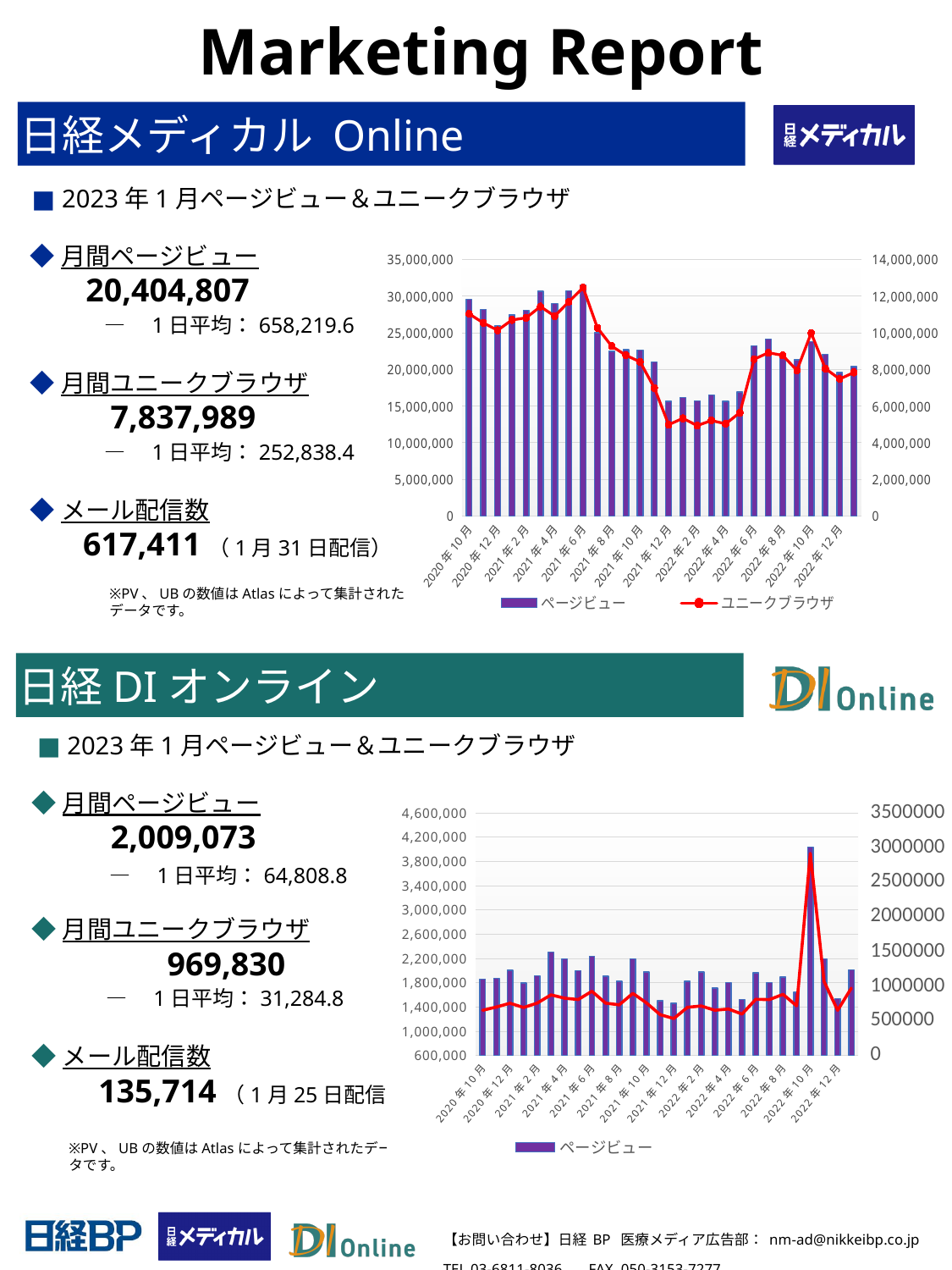
In the 日経メディカル Online chart, which month has the larger ページビュー bar, 2020年10月 or 2022年1月? 2020年10月 In the 日経メディカル Online chart, which series is drawn as a red line? ユニークブラウザ In the 日経DIオンライン chart, which month has the highest ページビュー bar? 2022年10月 In the 日経DIオンライン chart, is the ページビュー value for 2022年10月 greater or less than 3,800,000? greater In the 日経メディカル Online chart, is the ページビュー value for 2022年1月 greater or less than 20,000,000? less In the 日経DIオンライン chart, which month has the larger ページビュー bar, 2021年4月 or 2021年12月? 2021年4月 How many series does the legend of the 日経メディカル Online chart list? 2 How many series does the legend of the 日経DIオンライン chart list? 1 What kind of chart is shown in the 日経メディカル Online section? Combined bar and line chart In the 日経メディカル Online chart, do the ページビュー bars rise or fall from 2021年6月 to 2022年1月? fall In the 日経メディカル Online chart, in which month does the ユニークブラウザ line reach its highest point? 2021年6月 In the 日経メディカル Online chart, is the ページビュー value for 2020年10月 greater or less than 25,000,000? greater